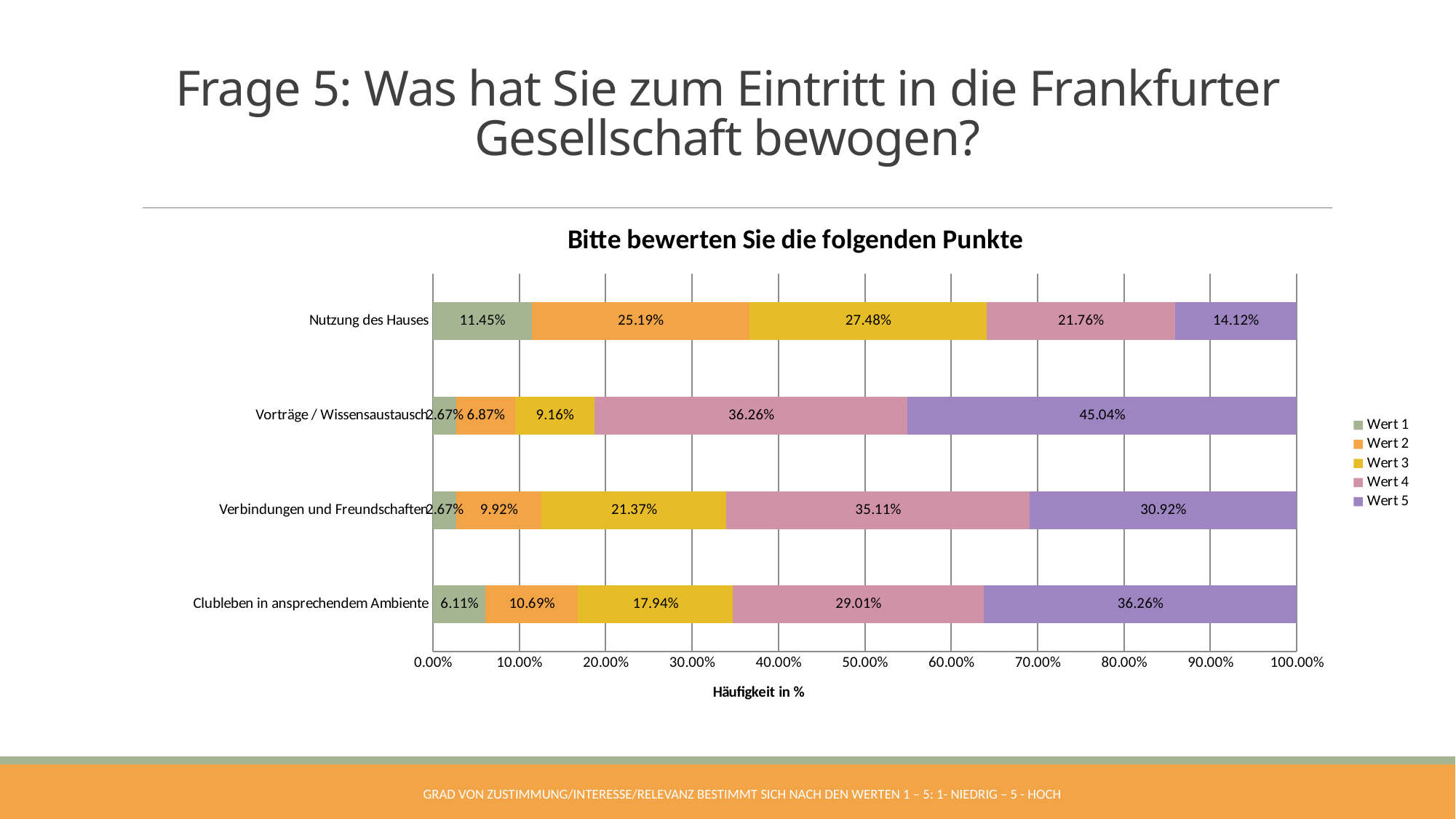
Which is larger: the Wert 3 value for Nutzung des Hauses or for Verbindungen und Freundschaften? Nutzung des Hauses Which category has the highest value for Wert 5? Vorträge / Wissensaustausch Which category has the lowest value for Wert 2? Vorträge / Wissensaustausch What is the total of the stacked bar for Nutzung des Hauses? 100.00% What is the difference between the Wert 4 values for Verbindungen und Freundschaften and Nutzung des Hauses? 13.35 percentage points What is the title of the horizontal axis? Häufigkeit in % What kind of chart is shown on the slide? Stacked bar chart How many series does the legend list? 5 What is the value of Wert 1 for Clubleben in ansprechendem Ambiente? 6.11% What is the value of Wert 5 for Vorträge / Wissensaustausch? 45.04% How many categories are shown on the chart? 4 What is the value of Wert 3 for Nutzung des Hauses? 27.48%